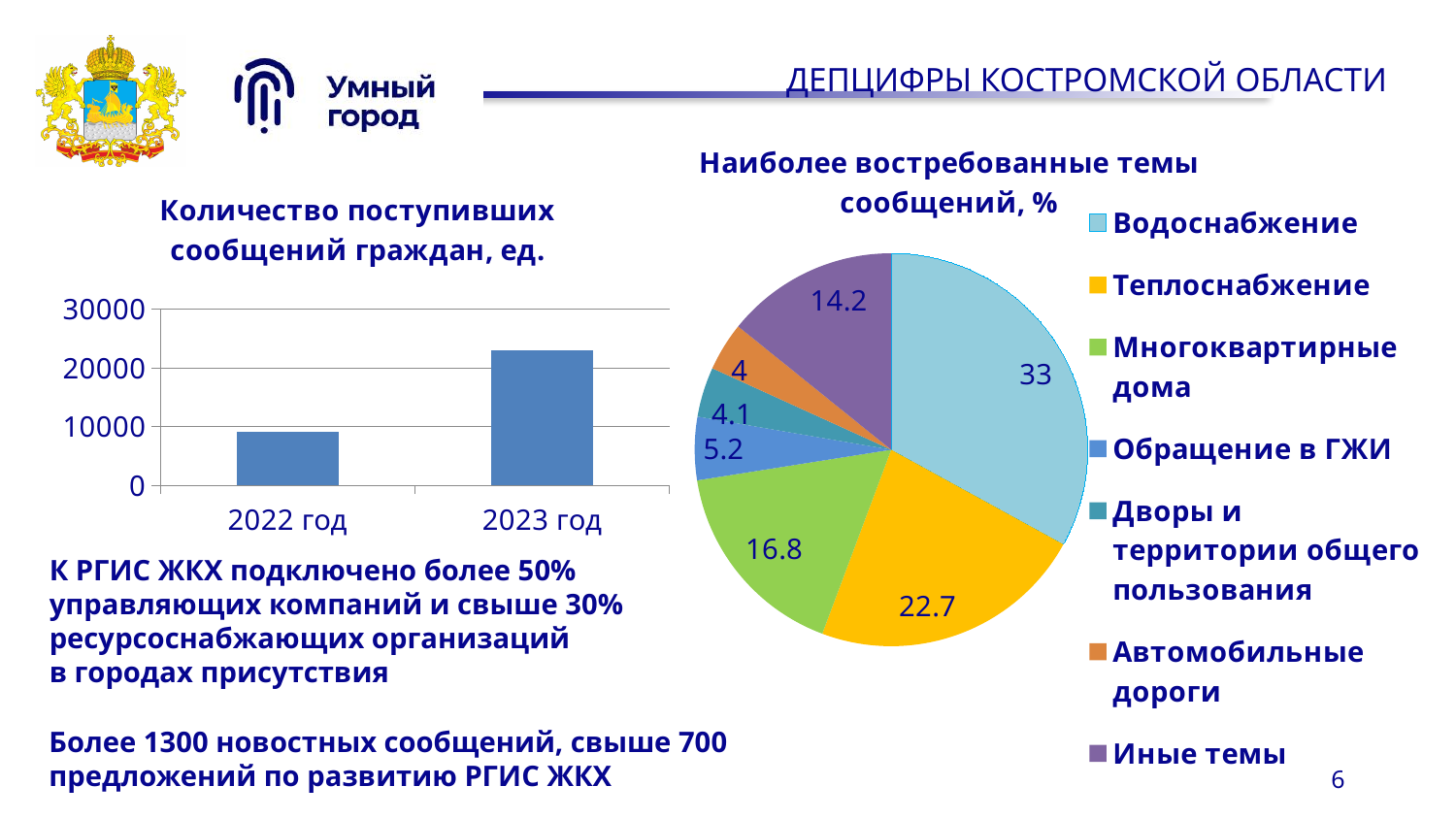
In the pie chart 'Наиболее востребованные темы сообщений, %', what is the difference between Многоквартирные дома and Иные темы? 2.6 In the bar chart 'Количество поступивших сообщений граждан, ед.', how many categories are shown on the x axis? 2 In the pie chart 'Наиболее востребованные темы сообщений, %', which category has the smallest share? Автомобильные дороги In the pie chart 'Наиболее востребованные темы сообщений, %', what is the value for Теплоснабжение? 22.7 In the bar chart 'Количество поступивших сообщений граждан, ед.', which year has the higher value? 2023 год In the bar chart 'Количество поступивших сообщений граждан, ед.', is the value for 2022 год greater or less than 10000? less In the bar chart 'Количество поступивших сообщений граждан, ед.', do the values rise or fall from 2022 год to 2023 год? rise In the bar chart 'Количество поступивших сообщений граждан, ед.', what kind of chart is shown? bar chart In the bar chart 'Количество поступивших сообщений граждан, ед.', is the value for 2023 год greater or less than 20000? greater In the pie chart 'Наиболее востребованные темы сообщений, %', which is larger: Обращение в ГЖИ or Дворы и территории общего пользования? Обращение в ГЖИ In the pie chart 'Наиболее востребованные темы сообщений, %', what is the value for Водоснабжение? 33 In the pie chart 'Наиболее востребованные темы сообщений, %', how many entries does the legend list? 7